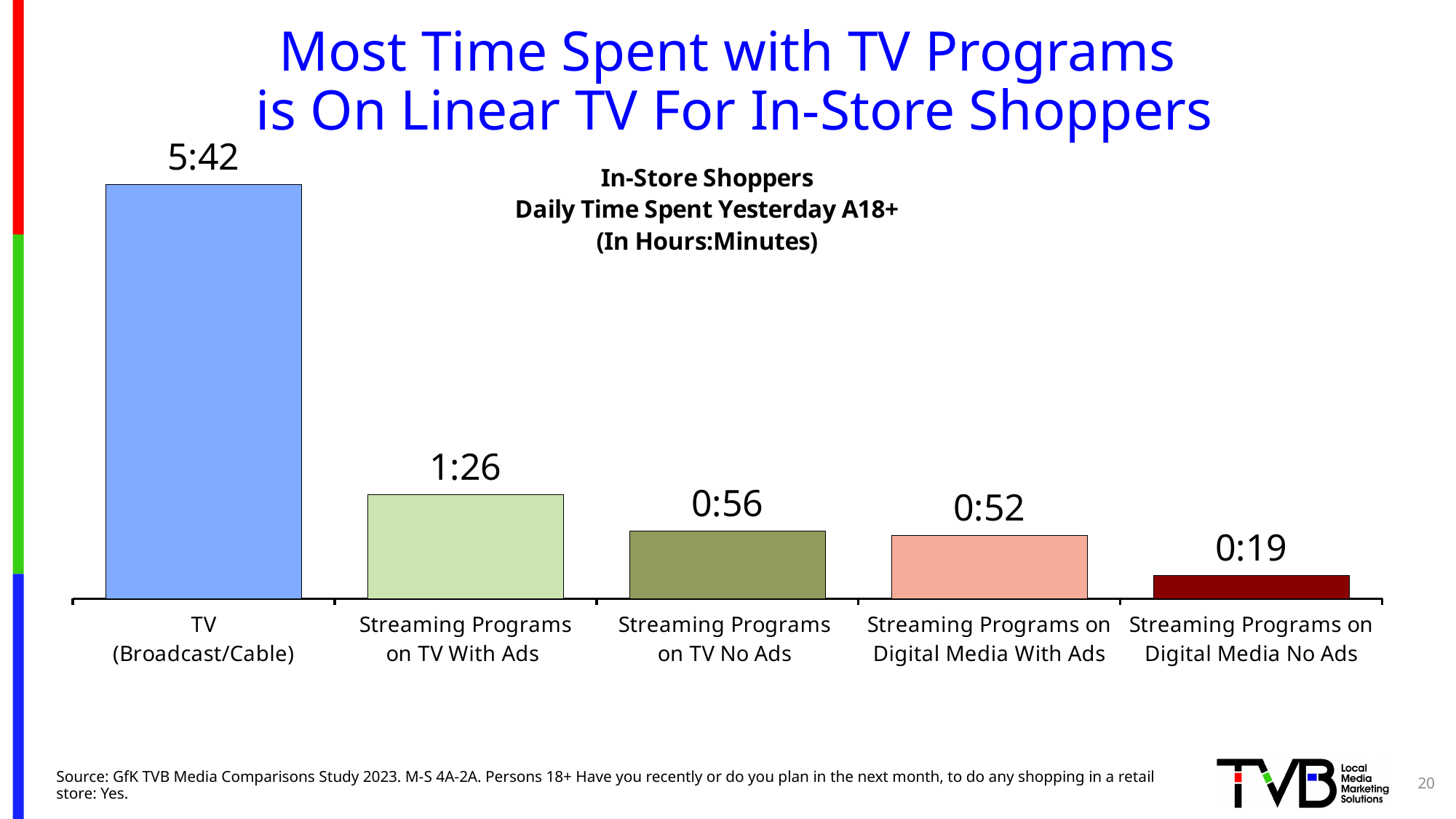
What is the daily time spent for Streaming Programs on TV With Ads? 1:26 What kind of chart is shown on the slide? Bar chart Which category has the highest daily time spent? TV (Broadcast/Cable) What is the daily time spent for Streaming Programs on Digital Media No Ads? 0:19 Which category has the lowest daily time spent? Streaming Programs on Digital Media No Ads What is the difference in daily time spent between TV (Broadcast/Cable) and Streaming Programs on TV With Ads? 4:16 What is the daily time spent for TV (Broadcast/Cable)? 5:42 What is the daily time spent for Streaming Programs on TV No Ads? 0:56 Do the values rise or fall moving from left to right across the categories? Fall Which has a larger daily time spent: Streaming Programs on TV No Ads or Streaming Programs on Digital Media With Ads? Streaming Programs on TV No Ads What is the difference in daily time spent between Streaming Programs on TV No Ads and Streaming Programs on Digital Media With Ads? 0:04 How many categories are shown in the chart? 5